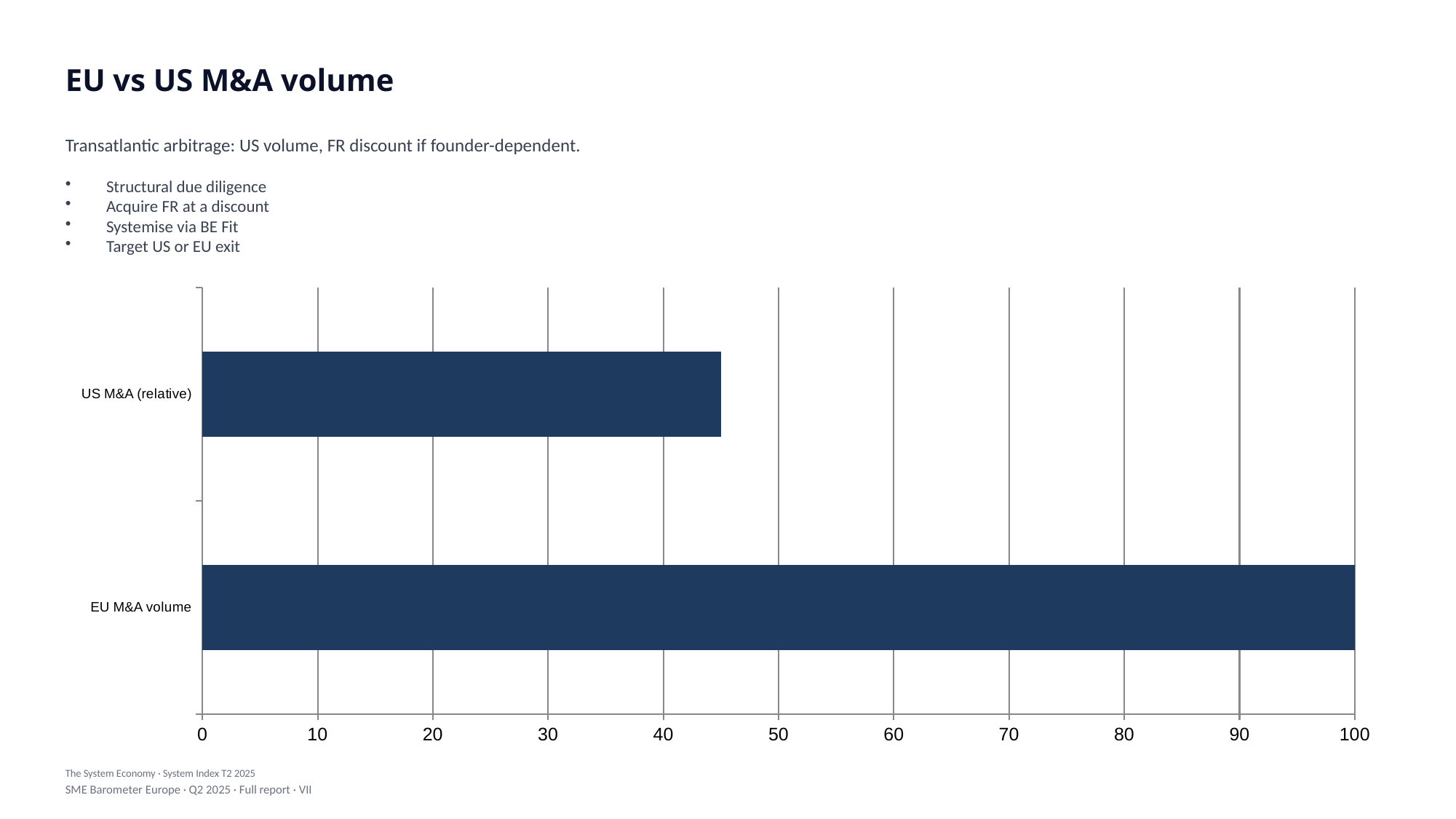
What kind of chart is shown on the slide? bar chart What is the title of the chart slide? EU vs US M&A volume Which is larger, the value for EU M&A volume or the value for US M&A (relative)? EU M&A volume How many categories are plotted in the chart? 2 What is the maximum value shown on the horizontal axis? 100 Is the value for US M&A (relative) greater or less than 50? less Is the value for EU M&A volume greater or less than 90? greater Which category has the lowest value? US M&A (relative) What is the value for EU M&A volume? 100 Is the value for US M&A (relative) greater or less than 40? greater Which category has the highest value? EU M&A volume